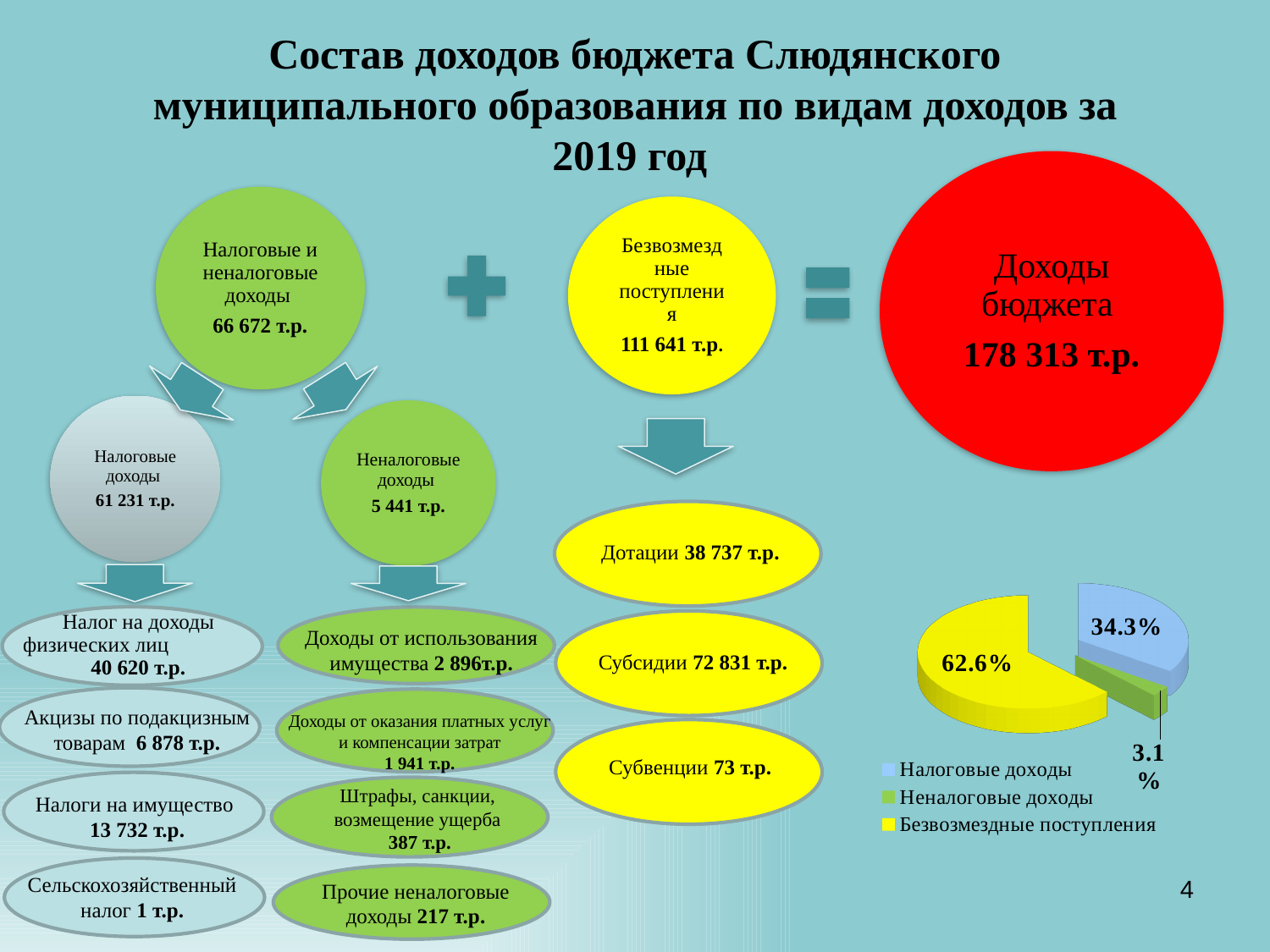
In the pie chart, what is the difference in percentage points between the share for Безвозмездные поступления and the share for Налоговые доходы? 28.3 In the pie chart, what is the difference in percentage points between the share for Налоговые доходы and the share for Неналоговые доходы? 31.2 Which category has the smallest slice in the pie chart? Неналоговые доходы How many entries does the legend of the pie chart list? 3 What kind of chart is shown in the bottom right of the slide? pie chart In the pie chart, which is larger: the share for Налоговые доходы or the share for Безвозмездные поступления? Безвозмездные поступления How many slices does the pie chart have? 3 What colour is the Безвозмездные поступления slice in the pie chart? yellow In the pie chart, what share is shown for Неналоговые доходы? 3.1% Which category has the largest slice in the pie chart? Безвозмездные поступления In the pie chart, what share is shown for Налоговые доходы? 34.3% In the pie chart, what share is shown for Безвозмездные поступления? 62.6%